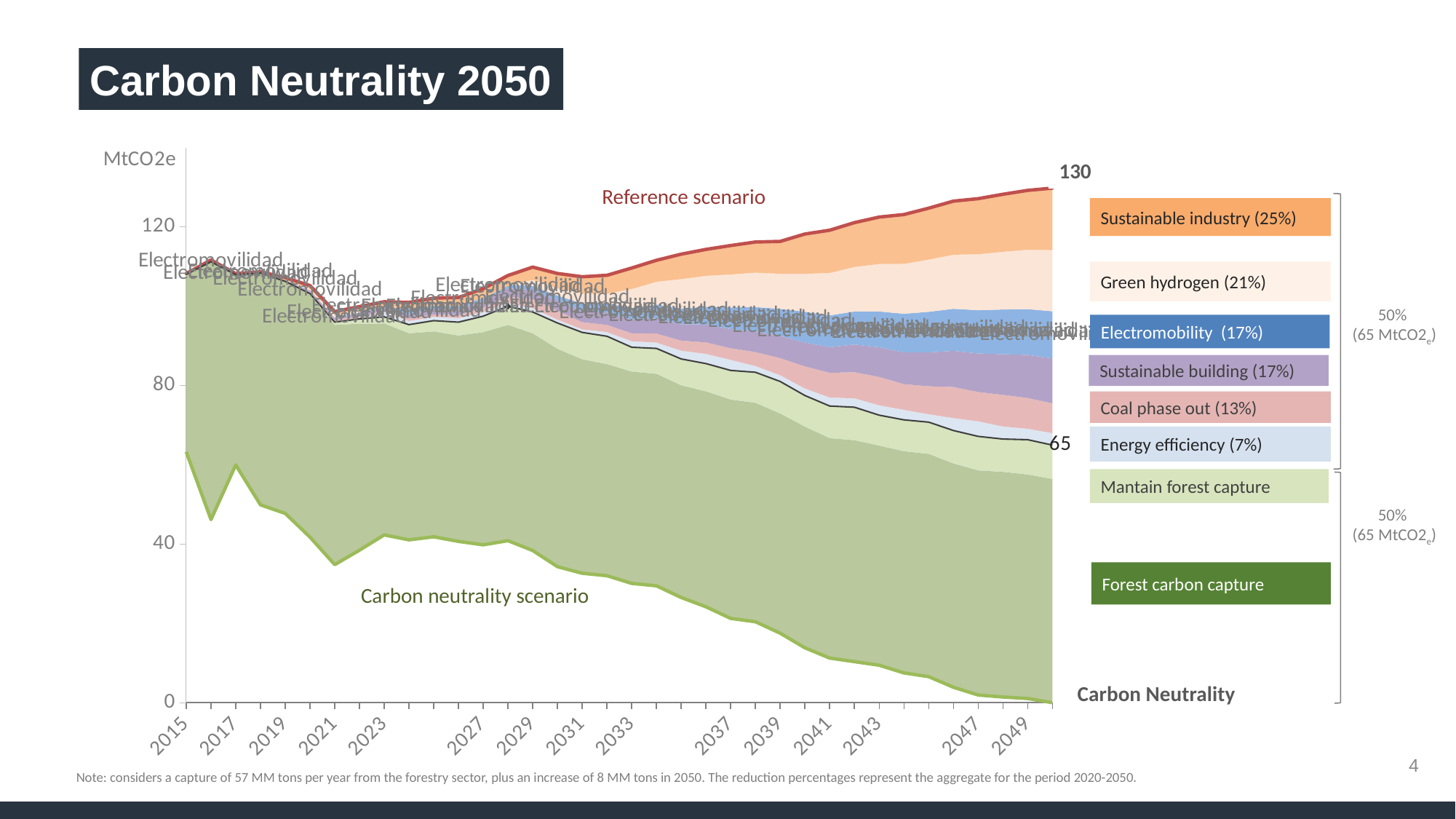
What is the difference between the Reference scenario value (130) and the value labelled 65 at the right edge of the chart? 65 Which legend entry has the highest percentage? Sustainable industry (25%) What percentage is shown in the legend for Coal phase out? 13% What percentage is shown in the legend for Sustainable industry? 25% What value does the Reference scenario reach in 2050, as labelled at the end of the red line? 130 What unit is shown on the y axis of the chart? MtCO2e What value is labelled at the right end of the black line in 2050? 65 What kind of chart is shown on the slide? Area chart Is the value of the Carbon neutrality scenario line in 2049 greater or less than 40? less Which has a larger percentage in the legend, Green hydrogen or Sustainable building? Green hydrogen Does the Carbon neutrality scenario line rise or fall overall from 2015 to 2049? Fall Which legend entry has the lowest percentage? Energy efficiency (7%)